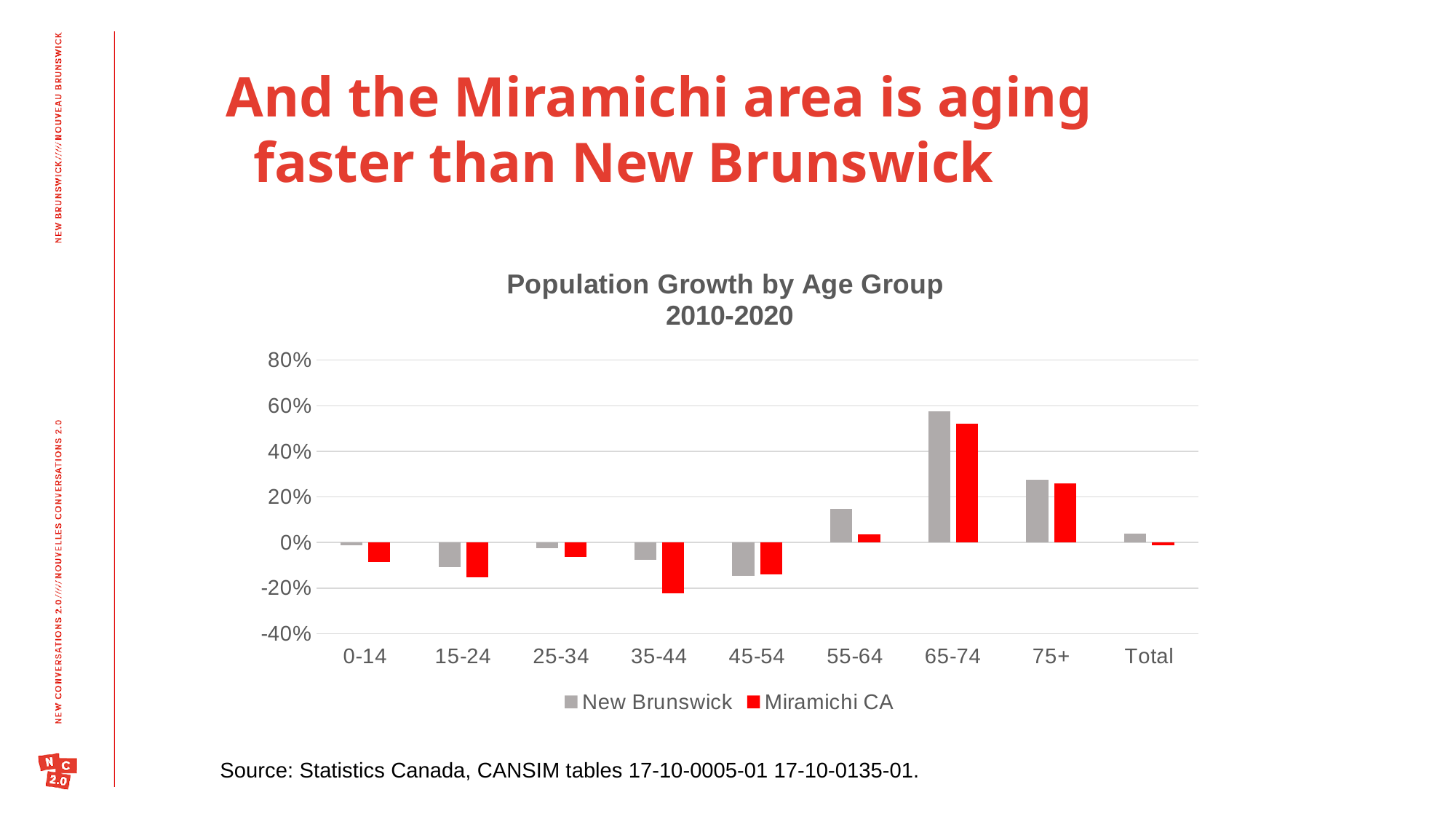
Which age group has the highest population growth for Miramichi CA? 65-74 Which age group has the lowest population growth for Miramichi CA? 35-44 What kind of chart is shown on the slide? Bar chart Is the Miramichi CA value for 35-44 greater or less than -20%? less Is the New Brunswick value for 65-74 greater or less than 40%? greater Which age group has the highest population growth for New Brunswick? 65-74 How many age-group categories (including Total) are shown on the x axis? 9 For the 55-64 age group, which series has the larger value, New Brunswick or Miramichi CA? New Brunswick What colour are the Miramichi CA bars in the chart? Red Is the Miramichi CA value for 55-64 greater or less than 20%? less How many series does the legend list in the Population Growth by Age Group chart? 2 For the Total category, which series has the larger value, New Brunswick or Miramichi CA? New Brunswick